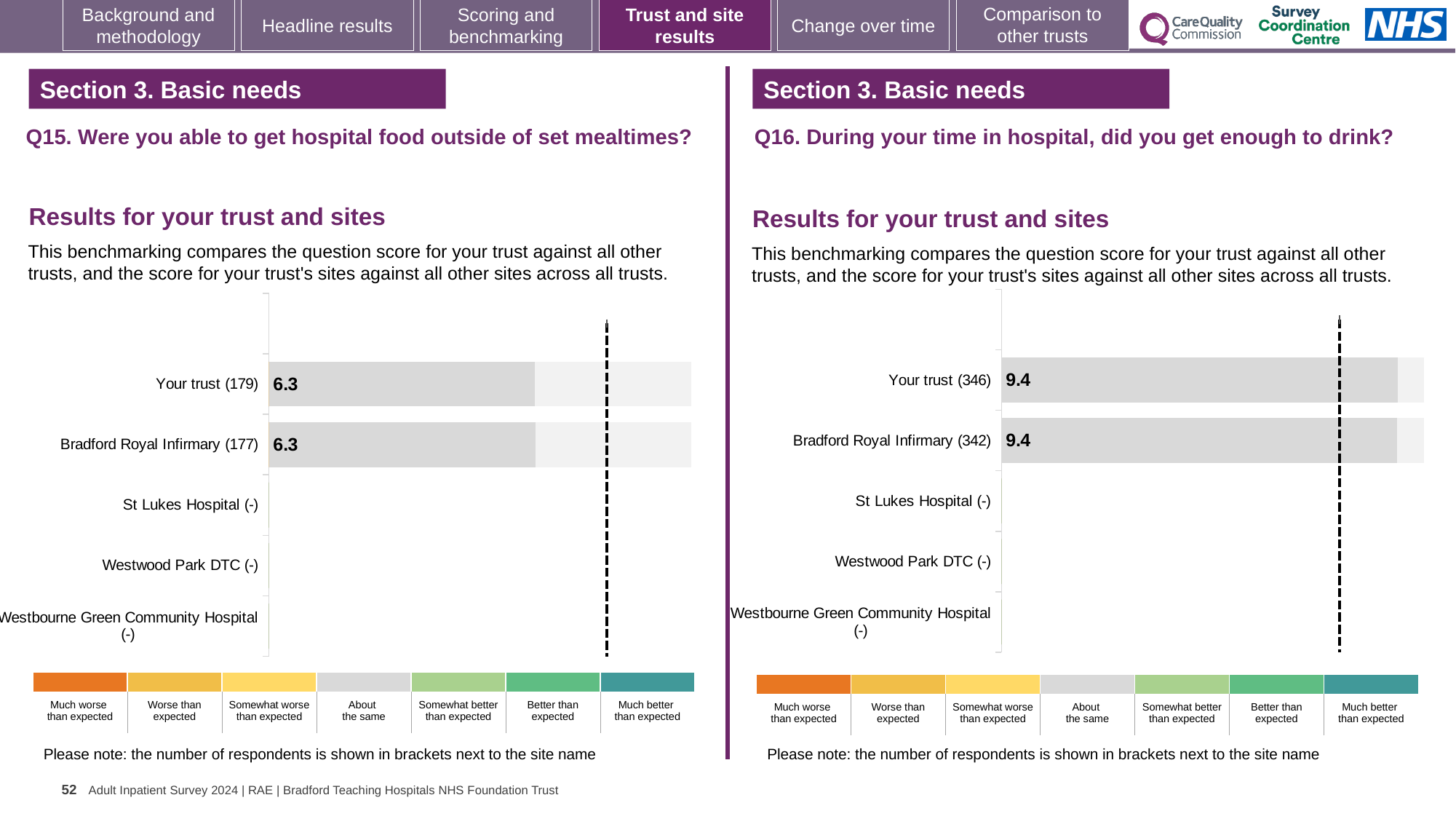
What is the question text shown above the right-hand chart? Q16. During your time in hospital, did you get enough to drink? In the Q15 chart (left), what is the score for Your trust? 6.3 In the Q15 chart (left), what is the difference between the score for Your trust and the score for Bradford Royal Infirmary? 0 In the Q15 chart (left), how many respondents are shown in brackets for Bradford Royal Infirmary? 177 In the Q16 chart (right), what is the score for Bradford Royal Infirmary? 9.4 What kind of chart is used in the Q16 chart (right)? Bar chart In the Q15 chart (left), what is the score for Bradford Royal Infirmary? 6.3 In the Q16 chart (right), what is the score for Your trust? 9.4 How many categories does the colour key below the Q15 chart (left) list? 7 In the Q16 chart (right), how many respondents are shown in brackets for Your trust? 346 How many site/trust categories are listed on the y axis of the Q15 chart (left)? 5